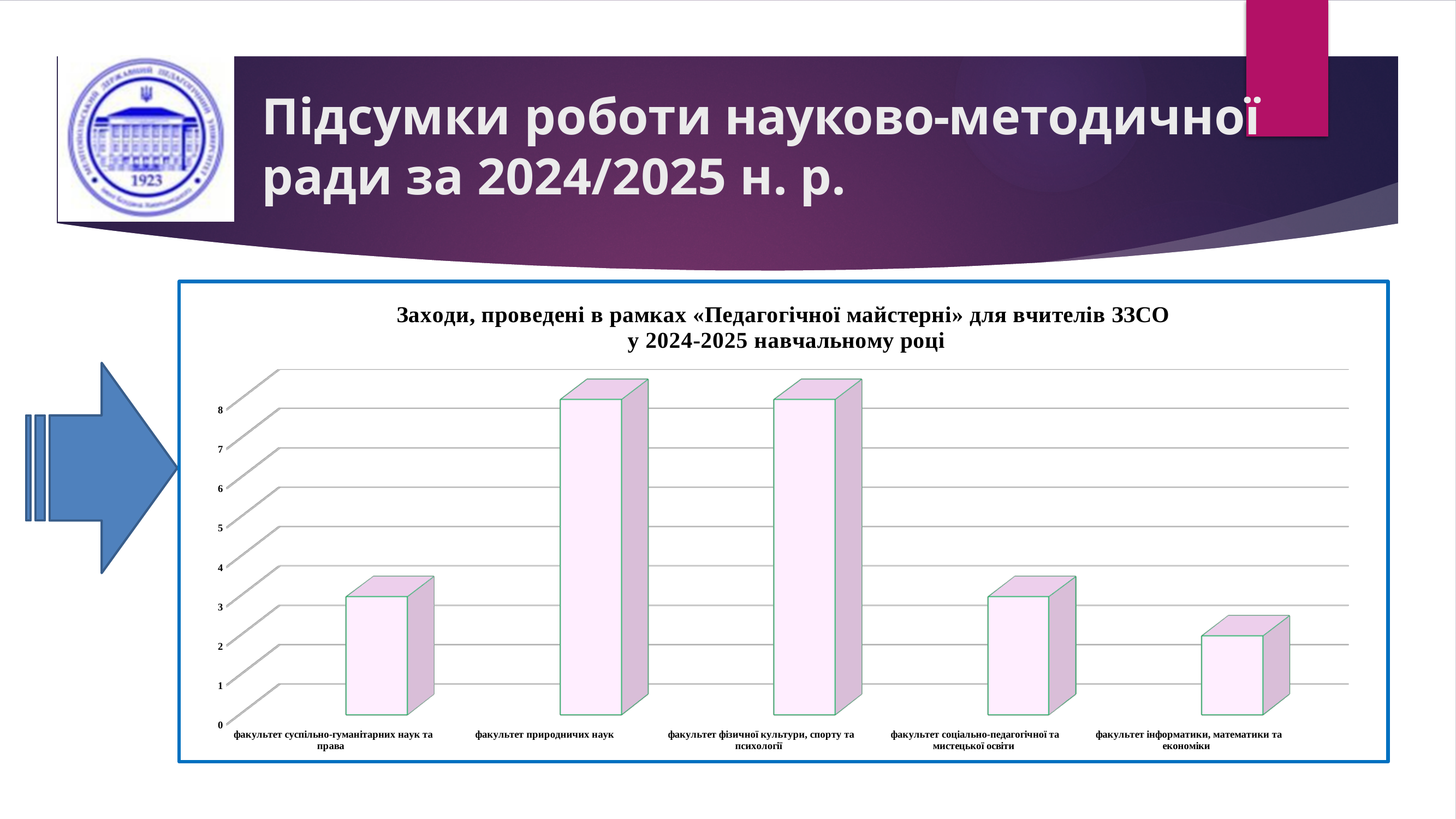
How many faculties (categories) are shown on the x axis of the chart? 5 What kind of chart is shown on the slide? bar chart Is the value for факультет інформатики, математики та економіки greater or less than 4? less Which faculty has the lowest bar in the chart? факультет інформатики, математики та економіки Is the value for факультет природничих наук greater or less than 5? greater Is the value for факультет фізичної культури, спорту та психології greater or less than 6? greater Which has the larger value: факультет природничих наук or факультет суспільно-гуманітарних наук та права? факультет природничих наук What is the highest tick value shown on the vertical axis of the chart? 8 Which has the larger value: факультет соціально-педагогічної та мистецької освіти or факультет інформатики, математики та економіки? факультет соціально-педагогічної та мистецької освіти What academic year is named in the chart title? 2024-2025